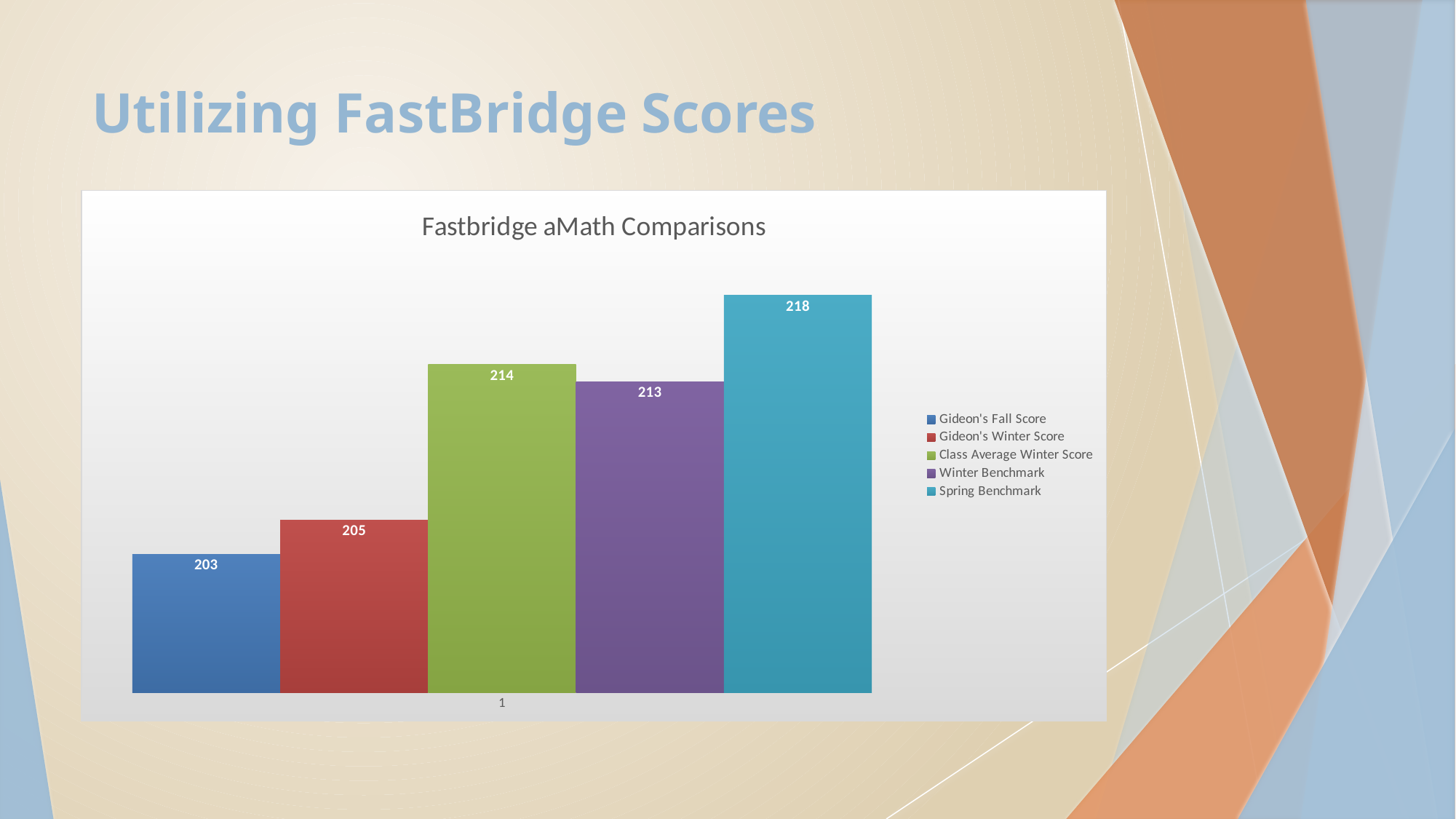
What is the value for Spring Benchmark? 218 What is the difference between the Class Average Winter Score and Gideon's Winter Score? 9 What is the value for Gideon's Winter Score? 205 What is the value for Winter Benchmark? 213 What is the value for Gideon's Fall Score? 203 Which series has the lowest value? Gideon's Fall Score How many series does the legend list? 5 What is the value for Class Average Winter Score? 214 Which is larger, Gideon's Winter Score or the Winter Benchmark? Winter Benchmark What is the title of the chart? Fastbridge aMath Comparisons What is the difference between the Spring Benchmark and Gideon's Winter Score? 13 Which series has the highest value? Spring Benchmark